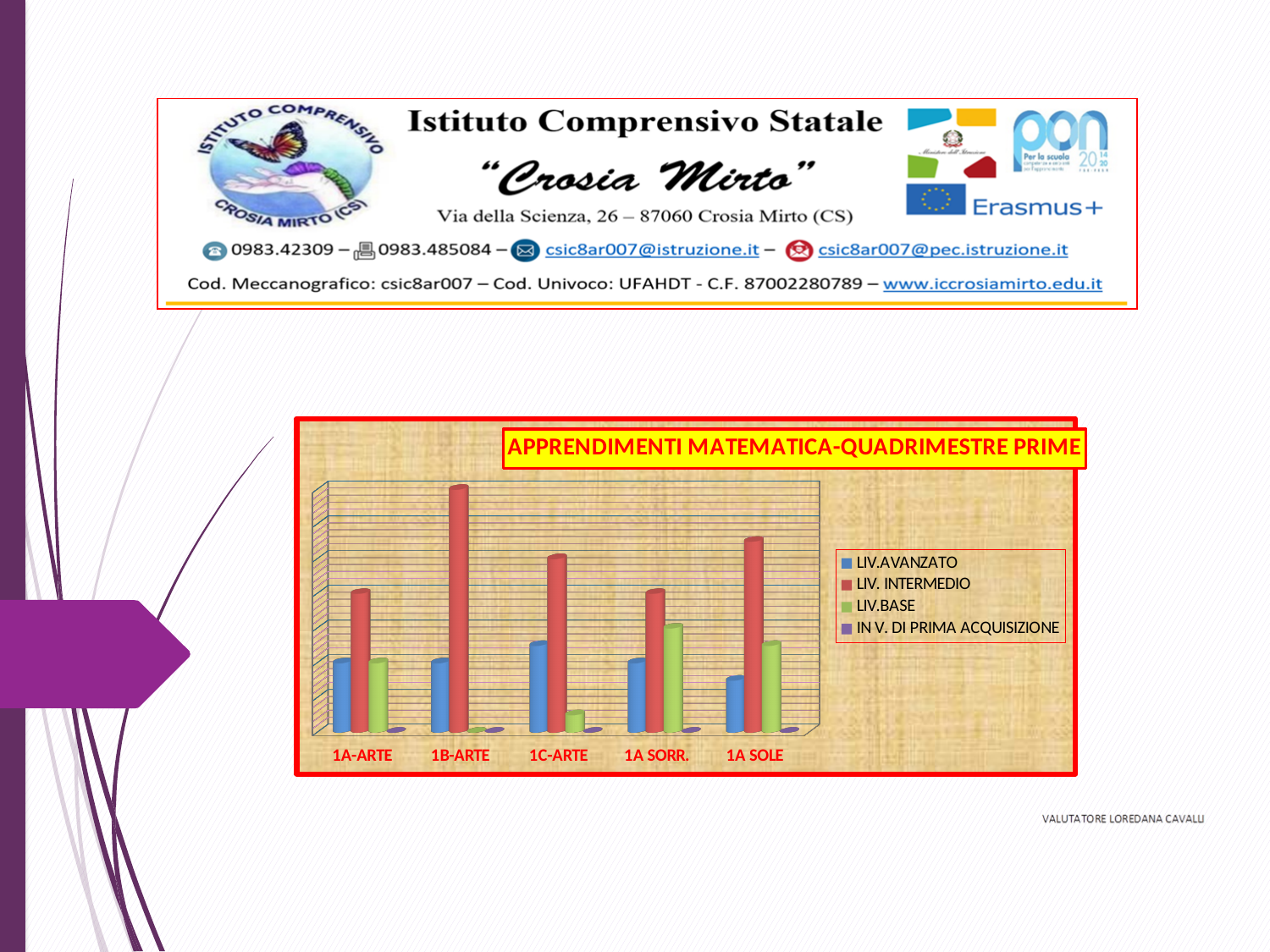
Which class has the lowest LIV.BASE bar? 1B-ARTE Which is larger: LIV. INTERMEDIO for 1B-ARTE or LIV. INTERMEDIO for 1A SOLE? 1B-ARTE Which class has the lowest LIV.AVANZATO bar? 1A SOLE How many series does the chart legend list? 4 In 1A SORR., which is larger: LIV.AVANZATO or LIV.BASE? LIV.BASE Which class has the highest LIV. INTERMEDIO bar? 1B-ARTE Which series is shown in red in the chart? LIV. INTERMEDIO How many classes (categories) are shown on the x axis of the chart? 5 What is the title of the chart? APPRENDIMENTI MATEMATICA-QUADRIMESTRE PRIME Which series has the tallest bar in every class? LIV. INTERMEDIO In 1C-ARTE, which is larger: LIV.AVANZATO or LIV.BASE? LIV.AVANZATO What kind of chart is shown on the slide? bar chart